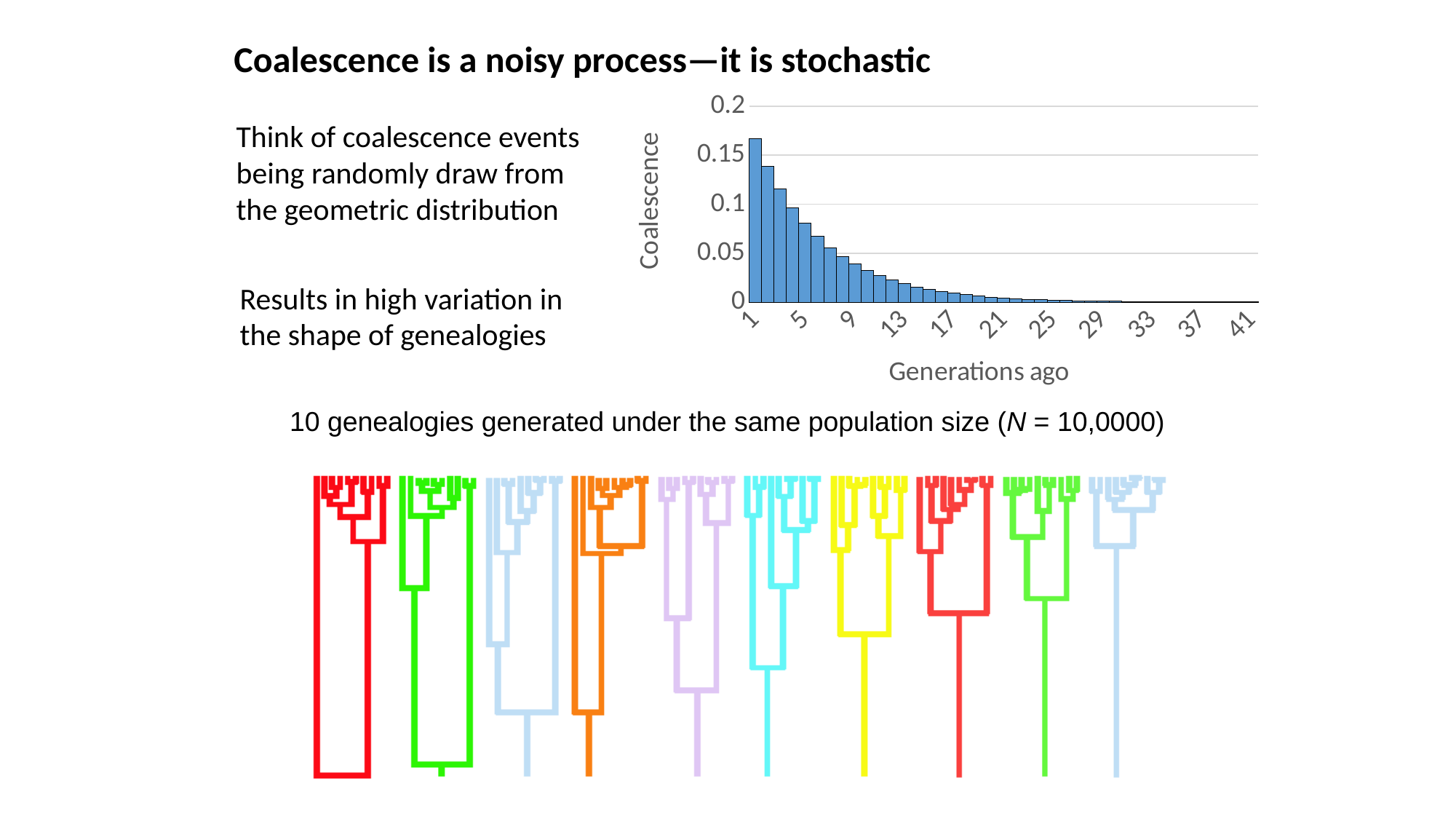
What is the label of the vertical axis of the bar chart? Coalescence In the bar chart, is the Coalescence value at 2 generations ago greater or less than 0.1? greater In the bar chart, which has the larger Coalescence value: 1 generation ago or 9 generations ago? 1 generation ago In the bar chart, is the Coalescence value at 13 generations ago greater or less than 0.05? less In the bar chart, which value of Generations ago has the highest Coalescence? 1 In the bar chart, is the Coalescence value at 1 generation ago greater or less than 0.15? greater What is the label of the horizontal axis of the bar chart? Generations ago In the bar chart, do the Coalescence values rise or fall as Generations ago increases? fall What kind of chart is shown at the top right of the slide? bar chart